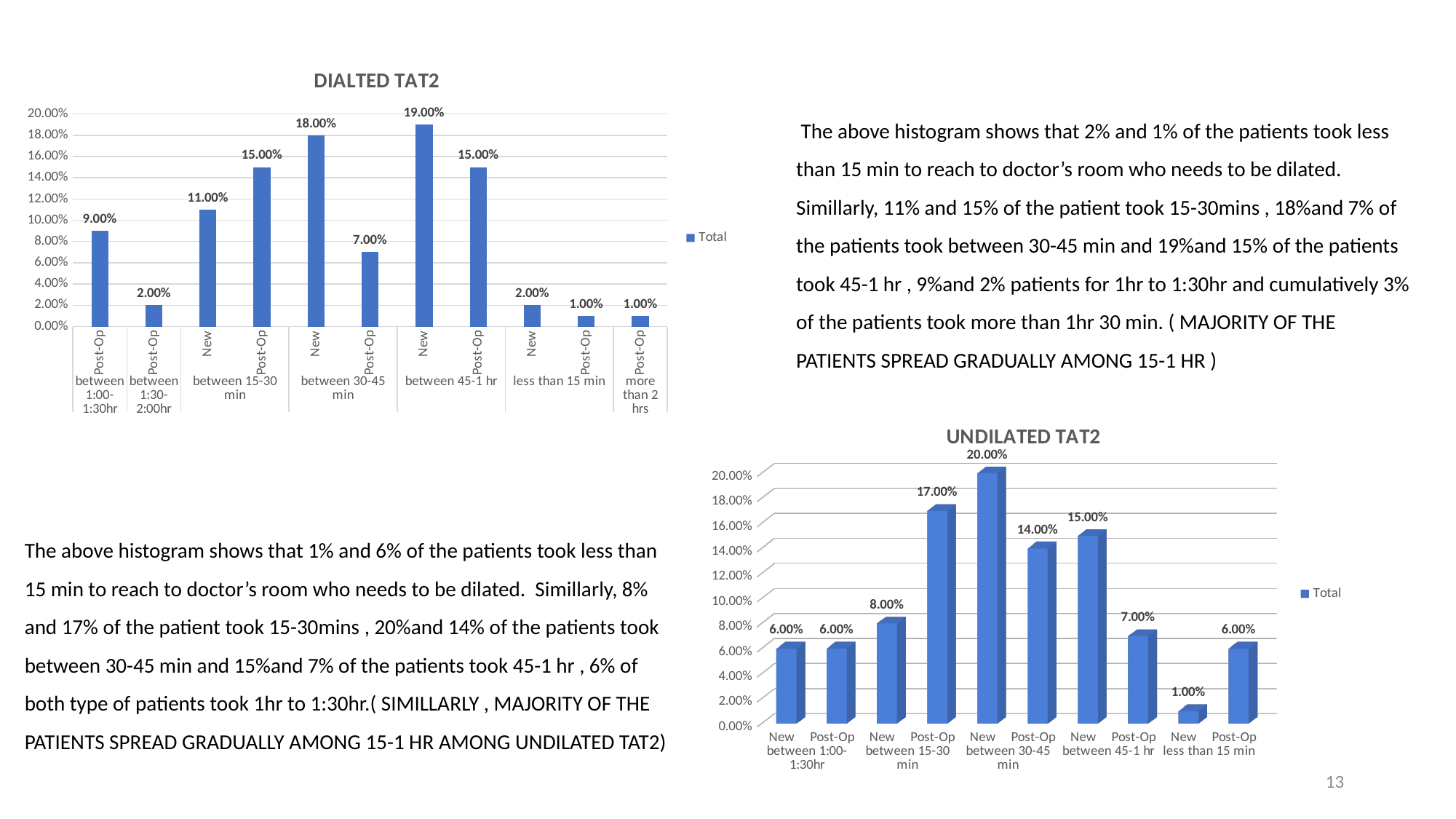
In the DIALTED TAT2 chart, what is the value for New patients between 45-1 hr? 19.00% In the DIALTED TAT2 chart, what is the value for Post-Op patients between 1:00-1:30hr? 9.00% In the DIALTED TAT2 chart, which bar has the highest value? New between 45-1 hr In the UNDILATED TAT2 chart, what is the difference between Post-Op between 15-30 min and New between 15-30 min? 9.00% In the DIALTED TAT2 chart, which is larger: New between 15-30 min or Post-Op between 15-30 min? Post-Op between 15-30 min In the DIALTED TAT2 chart, how many bars are plotted? 11 How many series does the legend of the DIALTED TAT2 chart list? 1 What kind of chart is the UNDILATED TAT2 chart? Bar chart In the UNDILATED TAT2 chart, how many bars are plotted? 10 In the UNDILATED TAT2 chart, which bar has the lowest value? New less than 15 min In the UNDILATED TAT2 chart, what is the value for New patients between 30-45 min? 20.00% In the DIALTED TAT2 chart, what is the difference between the New and Post-Op values for between 30-45 min? 11.00%